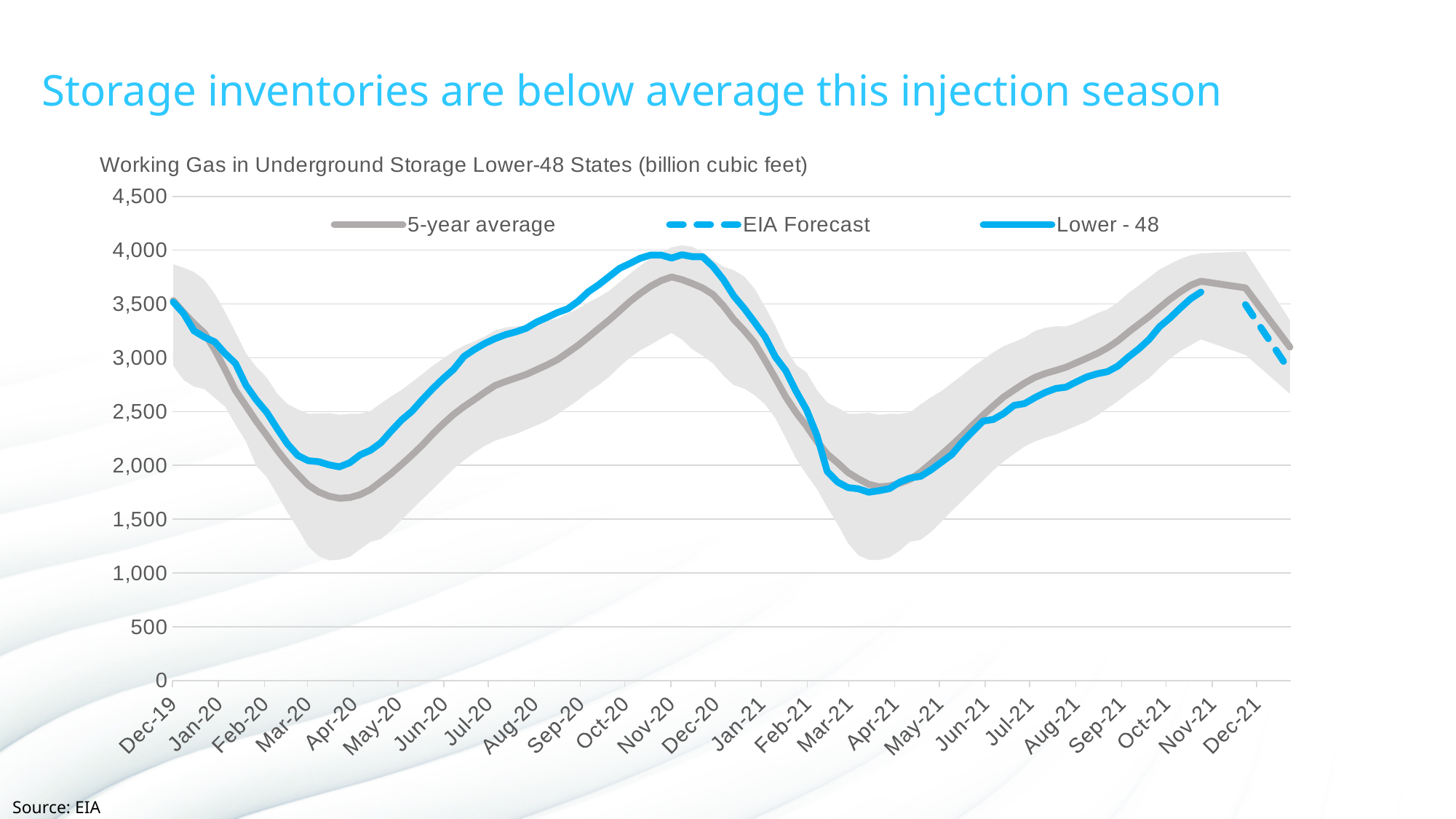
Around which month does the Lower - 48 series reach its highest value? Nov-20 What is the source cited for the chart? EIA At Jul-21, which is higher: the Lower - 48 series or the 5-year average? 5-year average Which series in the legend is drawn as a dashed line? EIA Forecast How many series does the legend list? 3 What kind of chart is shown on the slide? line chart Is the value of the Lower - 48 series at Oct-21 greater or less than 3,000? greater Is the value of the Lower - 48 series at Nov-20 greater or less than 3,500? greater Is the value of the 5-year average series at Apr-20 greater or less than 2,000? less Does the Lower - 48 series rise or fall between Dec-19 and Apr-20? fall At Nov-20, which is higher: the Lower - 48 series or the 5-year average? Lower - 48